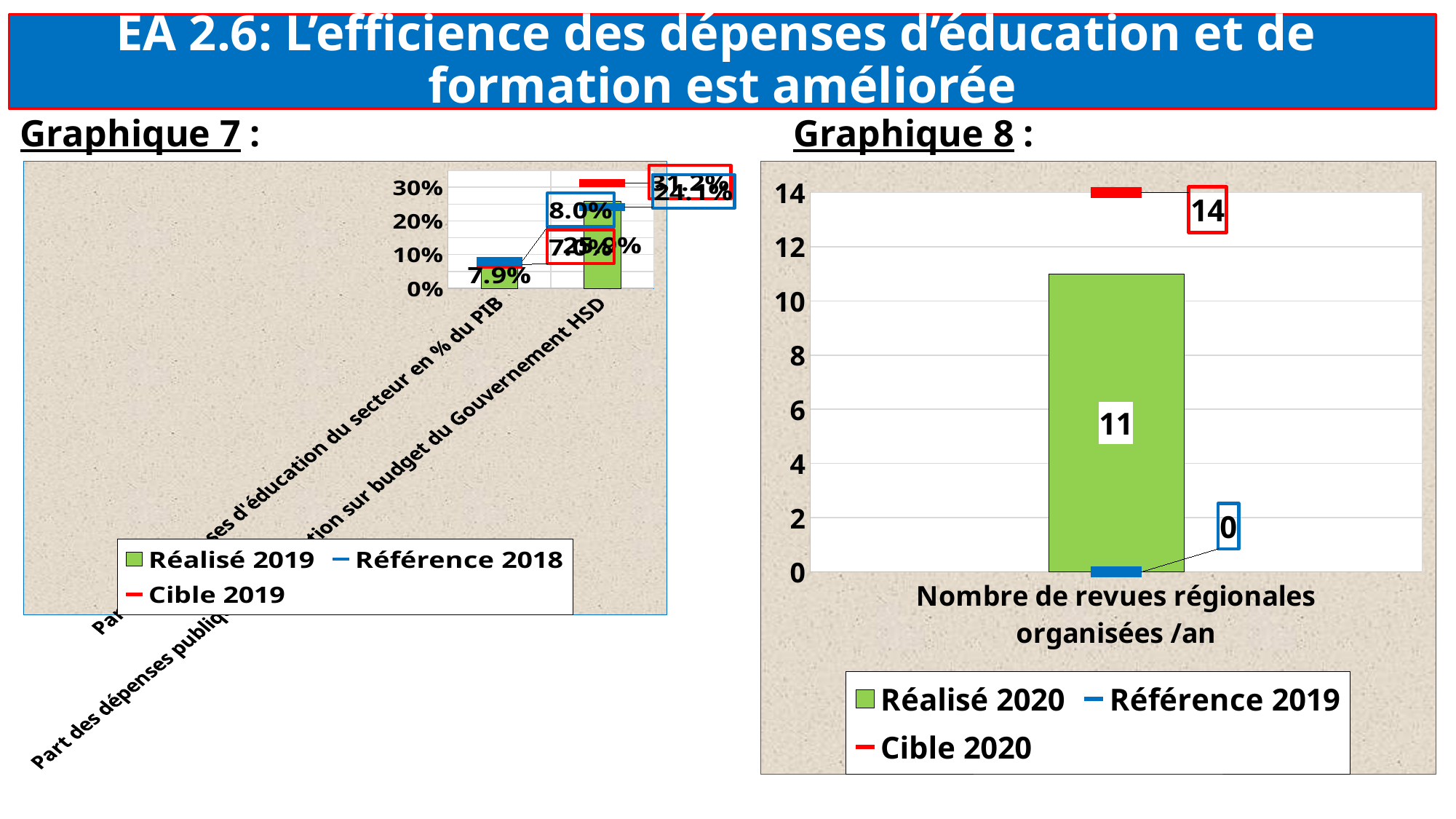
In Graphique 8, which is larger: Cible 2020 or Réalisé 2020? Cible 2020 In Graphique 8, is the value for Réalisé 2020 greater or less than 10? greater In Graphique 8, what is the value of Réalisé 2020 for 'Nombre de revues régionales organisées /an'? 11 In Graphique 7, how many series does the legend list? 3 In Graphique 8, how many series does the legend list? 3 In Graphique 8, what is the value of Référence 2019? 0 In Graphique 8, how many categories are shown on the x axis? 1 In Graphique 8, what is the difference between Cible 2020 and Réalisé 2020? 3 In Graphique 8, what is the value of Cible 2020? 14 In Graphique 7, how many categories are shown on the x axis? 2 What kind of chart is Graphique 8? bar chart In Graphique 7, what colour is used for the Cible 2019 series in the legend? red